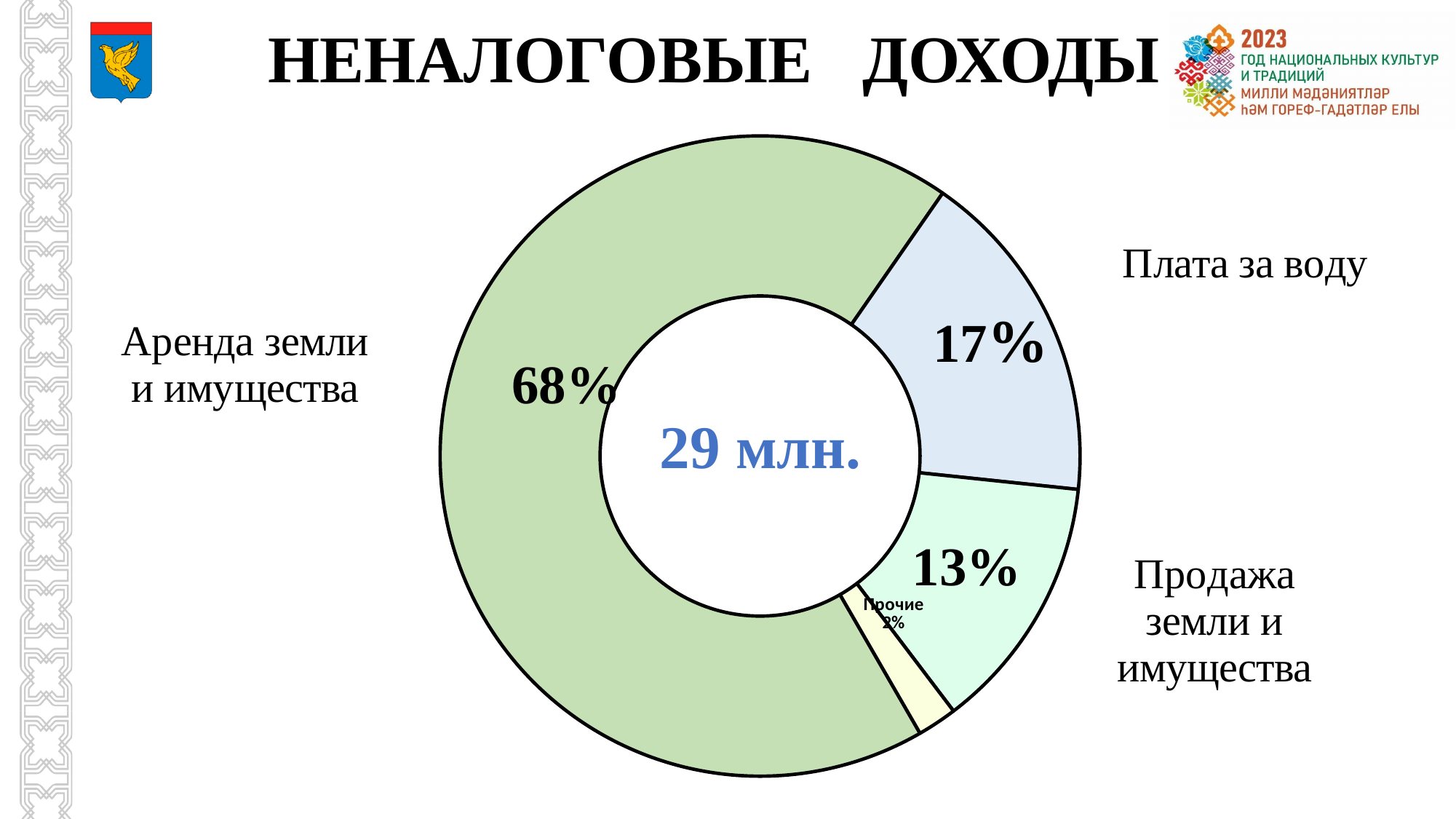
Which category has the smallest share of the pie? Прочие What kind of chart is shown on the slide? Pie chart (donut) How many slices does the pie chart have? 4 What is the title of the slide containing the chart? НЕНАЛОГОВЫЕ ДОХОДЫ Which is larger: the share for "Плата за воду" or the share for "Продажа земли и имущества"? Плата за воду What share of non-tax revenues comes from "Плата за воду"? 17% What share of non-tax revenues comes from "Продажа земли и имущества"? 13% What is the difference in percentage points between "Плата за воду" and "Продажа земли и имущества"? 4 percentage points What share of non-tax revenues comes from "Аренда земли и имущества"? 68% What share of non-tax revenues comes from "Прочие"? 2% What total amount is shown in the centre of the donut chart? 29 млн. Which category has the largest share of the pie? Аренда земли и имущества